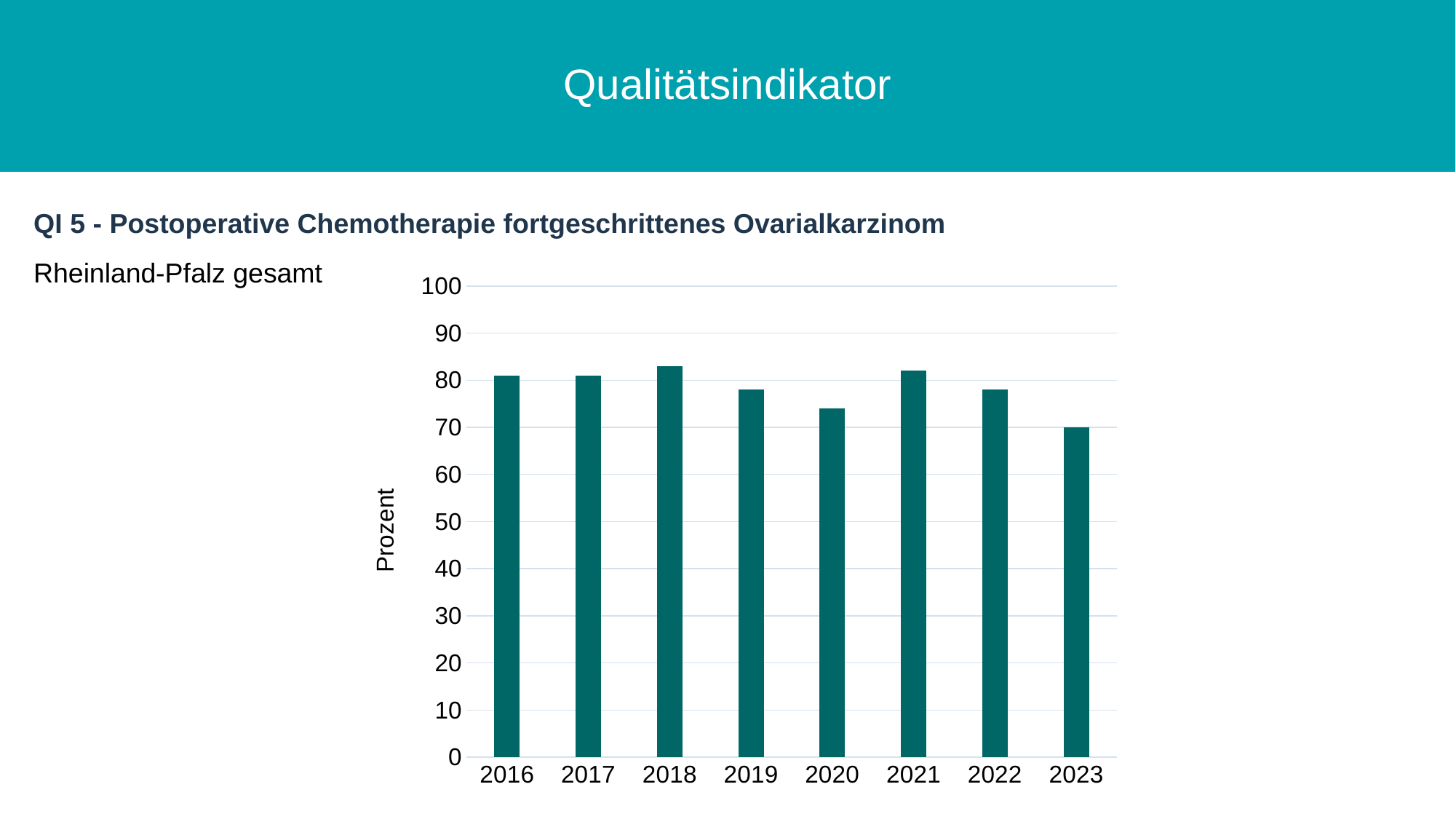
Which is larger, the value for 2021 or the value for 2023? 2021 Is the value for 2020 greater or less than 80? less What kind of chart is shown on the slide? bar chart Which is larger, the value for 2019 or the value for 2020? 2019 Which year has the lowest value in the chart? 2023 Is the value for 2023 greater or less than 80? less What region does the chart cover, according to the text above it? Rheinland-Pfalz gesamt Is the value for 2018 greater or less than 80? greater What is the label on the y axis of the chart? Prozent How many years are shown on the x axis of the chart? 8 Which is larger, the value for 2016 or the value for 2020? 2016